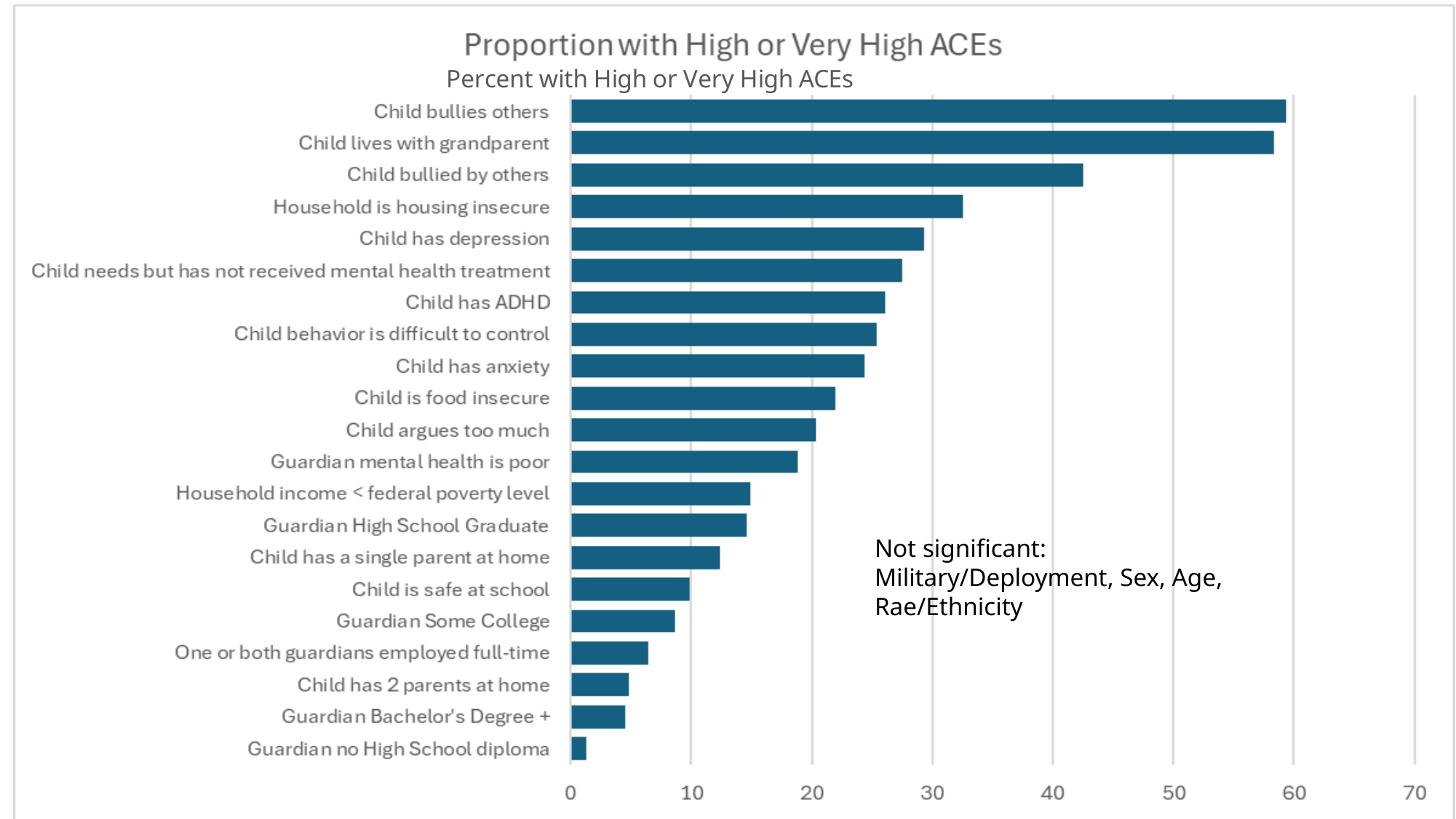
Is the value for Child bullied by others greater or less than 40? greater Is the value for Child has a single parent at home greater or less than 10? greater What is the highest value shown on the horizontal axis? 70 How many categories are plotted in the chart? 21 What kind of chart is shown on the slide? bar chart Is the value for Child lives with grandparent greater or less than 60? less What is the title of the chart? Percent with High or Very High ACEs Which category has the lowest value in the chart? Guardian no High School diploma Which is larger, the value for Child has ADHD or the value for Child has anxiety? Child has ADHD